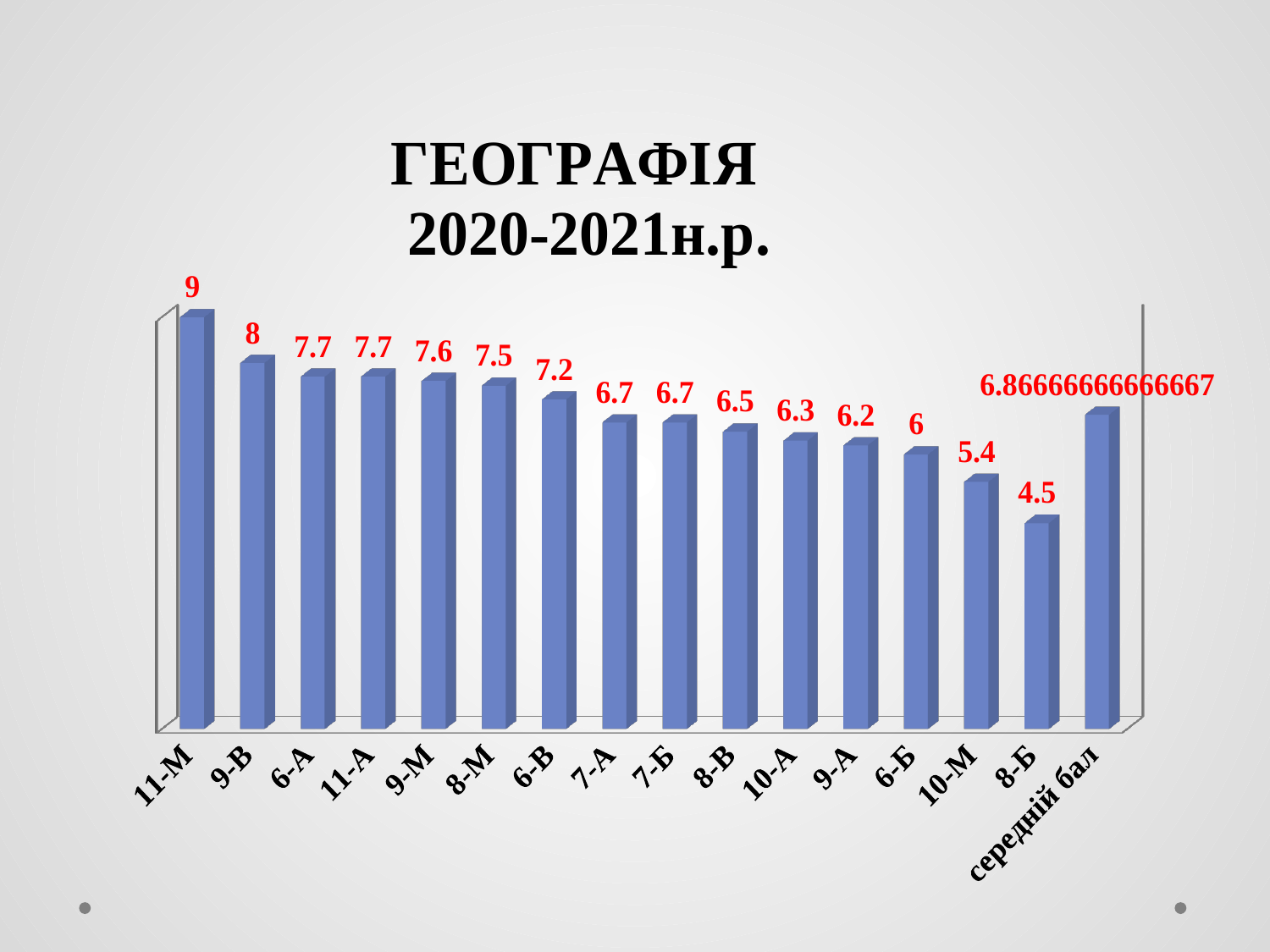
Which class has the lowest value? 8-Б What kind of chart is shown on the slide? Bar chart Which class has the highest value? 11-М What is the difference between the values for 11-М and 8-Б? 4.5 What is the value for 8-Б? 4.5 What is the value for 11-М? 9 What is the value for 10-М? 5.4 What is the value shown for середній бал? 6.86666666666667 What is the title of the chart? ГЕОГРАФІЯ 2020-2021н.р. Which is larger, the value for 9-М or the value for 8-В? 9-М How many bars are plotted on the chart? 16 What is the difference between the values for 9-В and 6-Б? 2